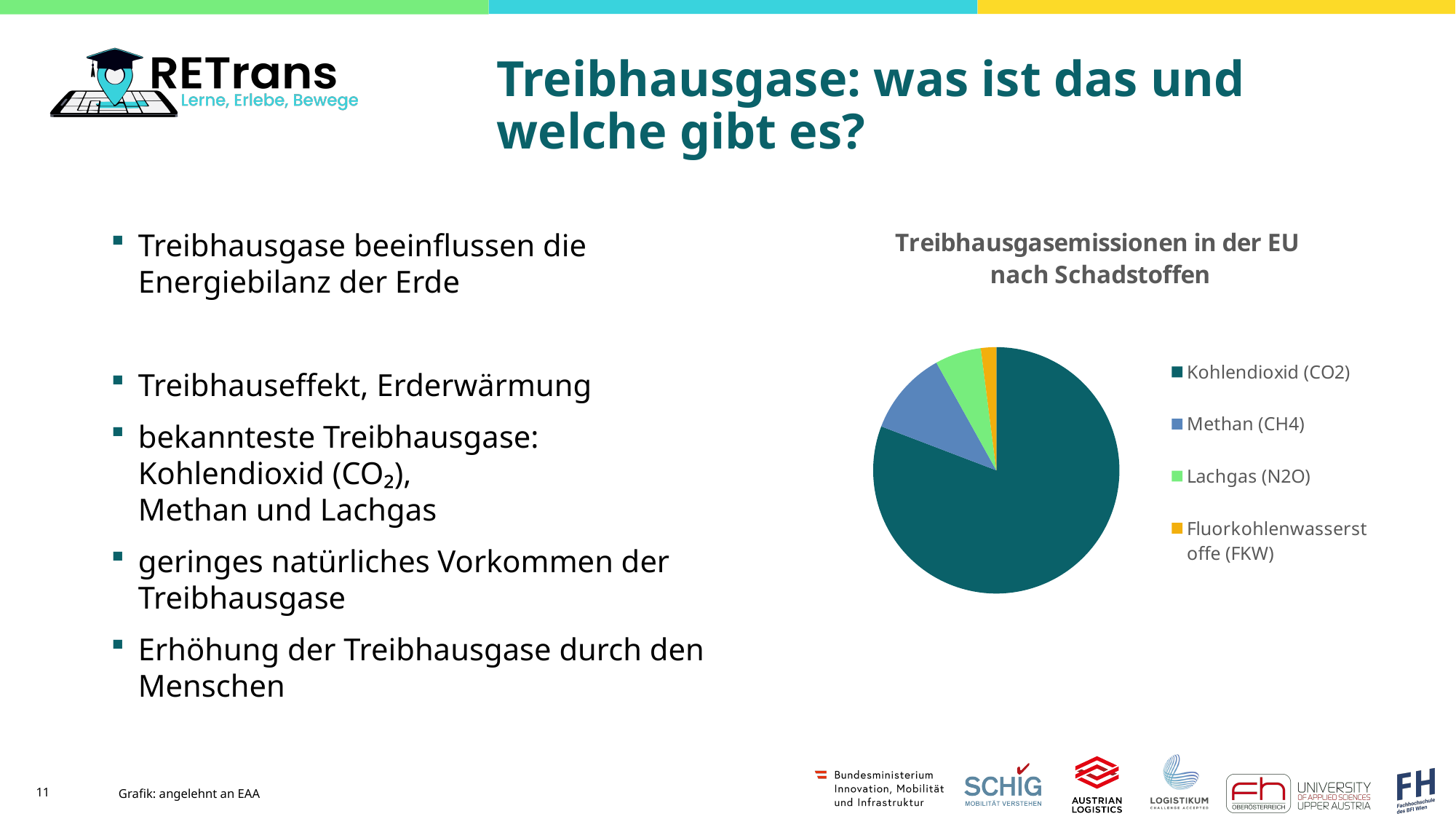
Which slice is larger in the pie chart, Kohlendioxid (CO2) or Methan (CH4)? Kohlendioxid (CO2) Which category is the second-largest slice in the pie chart? Methan (CH4) How many entries does the legend of the pie chart list? 4 Which category has the largest slice in the pie chart? Kohlendioxid (CO2) Which slice is larger in the pie chart, Methan (CH4) or Lachgas (N2O)? Methan (CH4) What kind of chart is shown on the slide? pie chart Which category is shown in orange in the pie chart? Fluorkohlenwasserstoffe (FKW) How many categories does the pie chart show? 4 Which category has the smallest slice in the pie chart? Fluorkohlenwasserstoffe (FKW) What is the title of the pie chart? Treibhausgasemissionen in der EU nach Schadstoffen Which slice is larger in the pie chart, Lachgas (N2O) or Fluorkohlenwasserstoffe (FKW)? Lachgas (N2O)